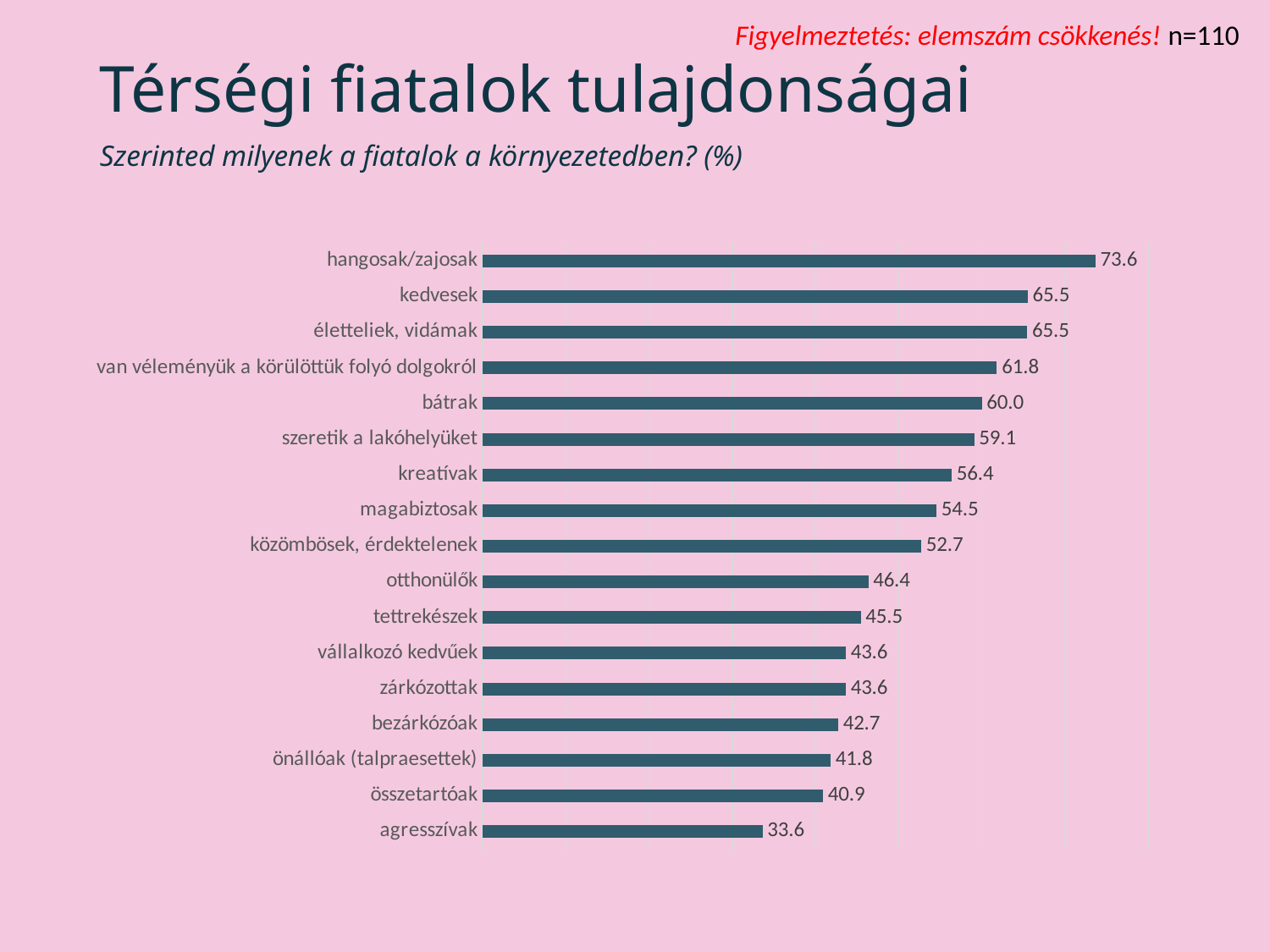
What is the subtitle question shown above the chart? Szerinted milyenek a fiatalok a környezetedben? (%) What is the value for "otthonülők"? 46.4 What kind of chart is shown on the slide? bar chart What is the value for "agresszívak"? 33.6 What is the value for "szeretik a lakóhelyüket"? 59.1 Which is larger, the value for "magabiztosak" or the value for "tettrekészek"? magabiztosak What is the value for "hangosak/zajosak"? 73.6 What is the difference between the values for "bátrak" and "kreatívak"? 3.6 How many categories are shown in the chart? 17 Which category has the highest value? hangosak/zajosak Which category has the lowest value? agresszívak What is the difference between the values for "hangosak/zajosak" and "agresszívak"? 40.0